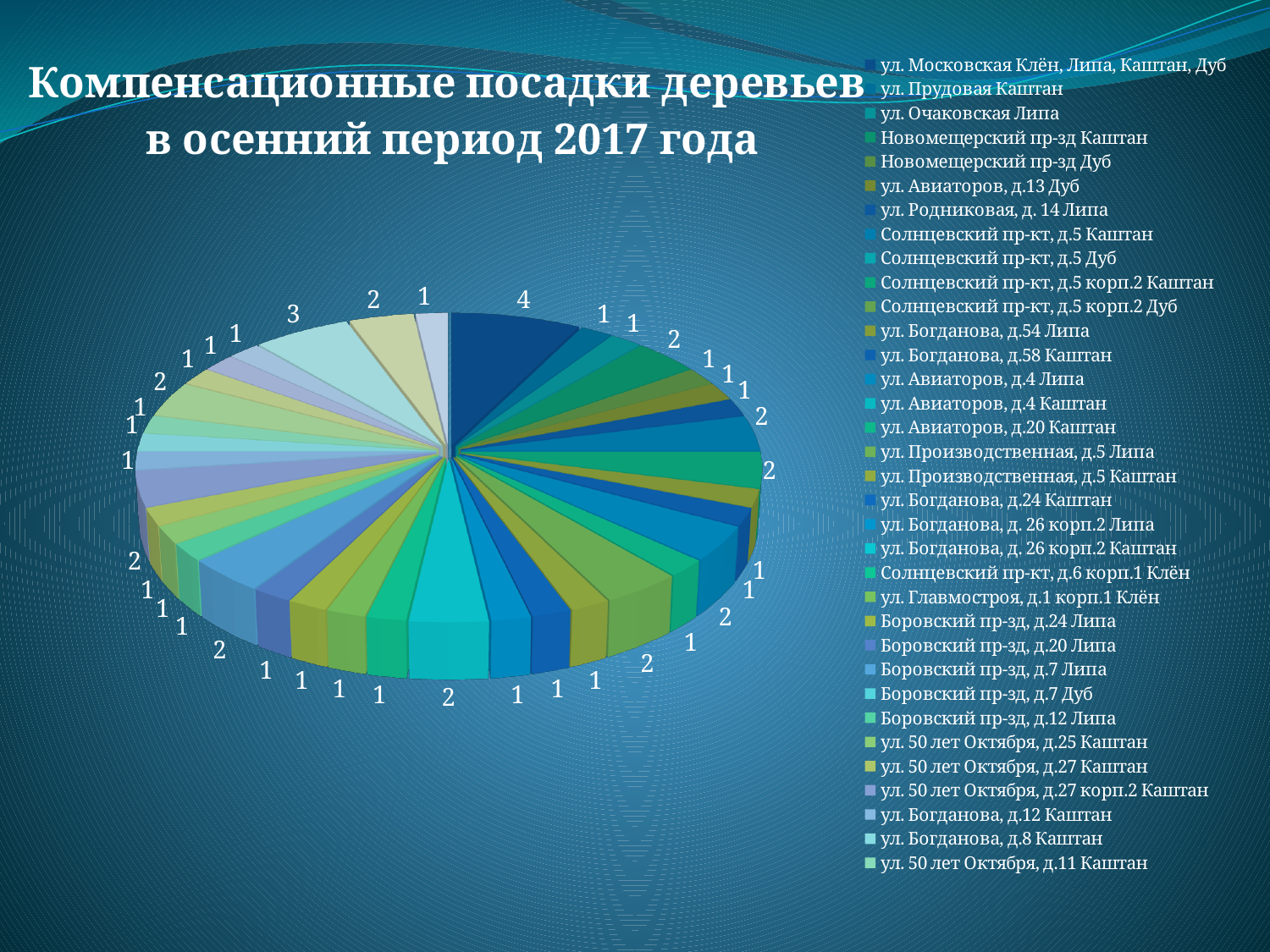
What is the smallest value labelled on any slice of the pie chart? 1 What is the difference between the largest slice value (4) and the slice labelled 3? 1 Which legend entry corresponds to the largest slice of the pie? ул. Московская Клён, Липа, Каштан, Дуб What kind of chart is shown on the slide? pie chart What is the first entry listed in the chart legend? ул. Московская Клён, Липа, Каштан, Дуб What is the value of the largest slice in the pie chart? 4 How many entries does the chart legend list? 34 What value is shown for ул. Московская Клён, Липа, Каштан, Дуб? 4 What is the title of the chart on the slide? Компенсационные посадки деревьев в осенний период 2017 года